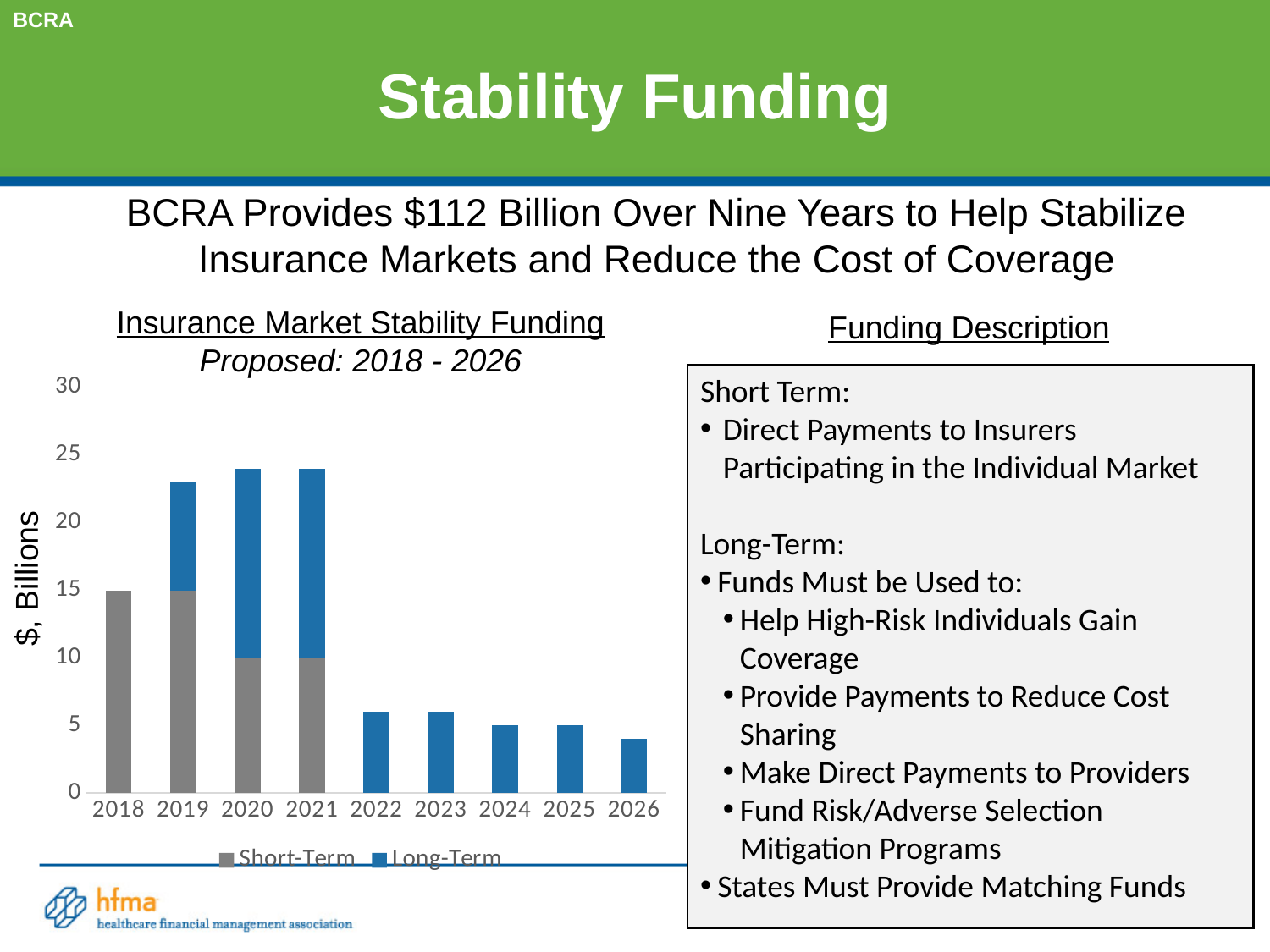
Which year has the larger total funding, 2019 or 2018? 2019 Which year has the lowest total funding in the chart? 2026 Is the total funding for 2018 greater or less than 10? greater What is the label on the y axis of the chart? $, Billions Is the value for 2026 greater or less than 5? less Is the value for 2022 greater or less than 10? less What are the two series named in the chart legend? Short-Term and Long-Term How many series does the chart legend list? 2 How many years are shown on the x axis of the chart? 9 What kind of chart is shown on the slide? Stacked bar chart Do the funding values rise or fall from 2022 to 2026? fall